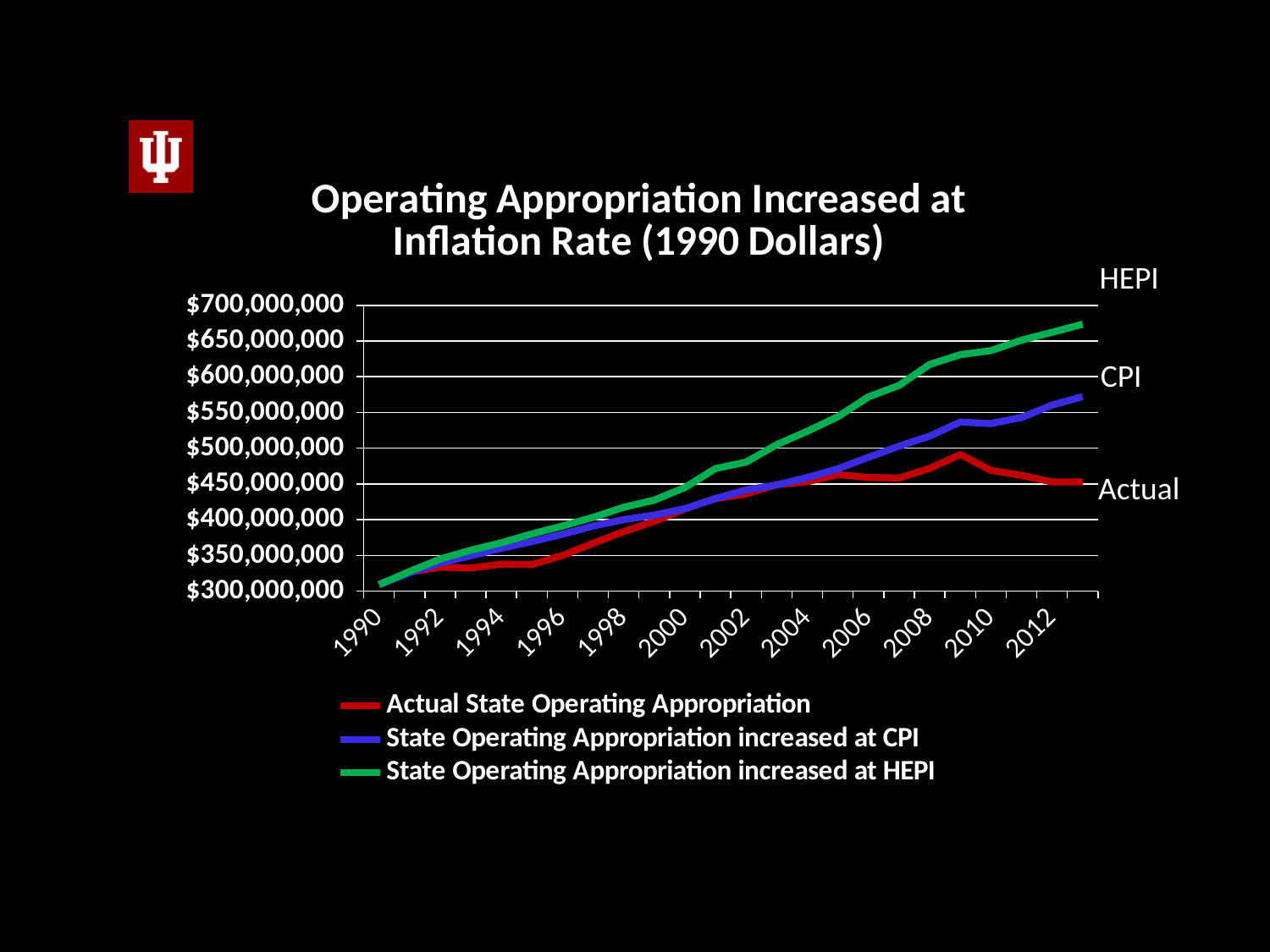
Which colour is used for the Actual State Operating Appropriation line? red Which series has the highest value at the right end of the chart? State Operating Appropriation increased at HEPI Does the HEPI line rise or fall from 1990 to the end of the chart? rise Which series has the lowest value at the right end of the chart? Actual State Operating Appropriation How many series does the legend list? 3 Is the value of the HEPI line in 2010 greater or less than $600,000,000? greater In 2008, which is larger: the HEPI line or the CPI line? HEPI Is the value of the CPI line in 2012 greater or less than $500,000,000? greater What is the title of the chart? Operating Appropriation Increased at Inflation Rate (1990 Dollars) Is the value of the Actual State Operating Appropriation line in 2012 greater or less than $500,000,000? less What kind of chart is shown on the slide? line chart In 2012, which is larger: the CPI line or the Actual line? CPI